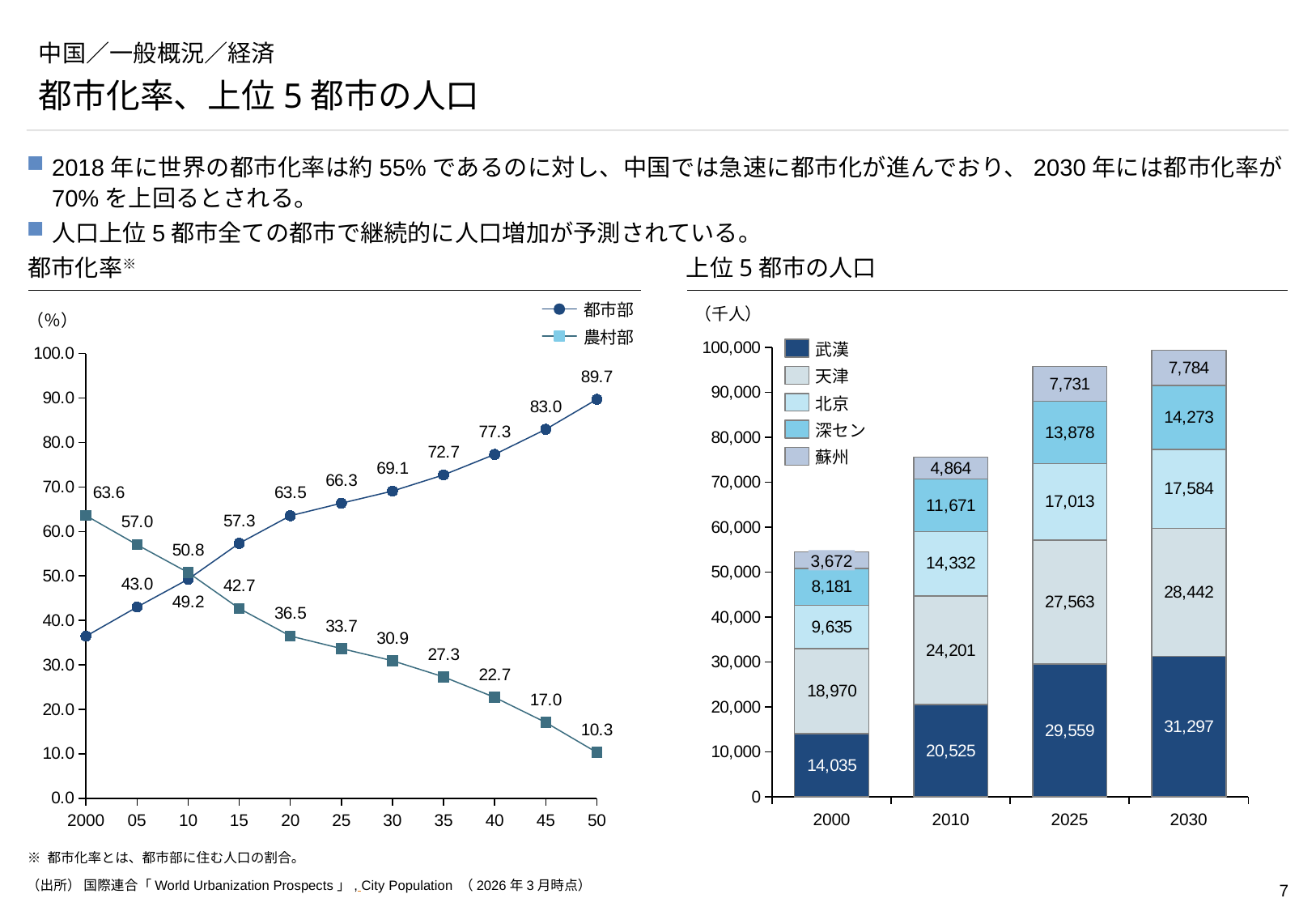
In the 上位5都市の人口 chart on the right, what is the total of the stacked bar for 2000? 54,493 In the 上位5都市の人口 chart on the right, which city has the largest value in 2030? 武漢 In the 上位5都市の人口 chart on the right, what is the value for 天津 in 2025? 27,563 In the 都市化率 chart on the left, does the 農村部 series rise or fall from 2000 to 2050? fall In the 都市化率 chart on the left, what is the 都市部 value for 2050? 89.7 In the 上位5都市の人口 chart on the right, how many years are shown on the x axis? 4 In the 都市化率 chart on the left, is the 都市部 value for 2000 greater or less than 40.0? less In the 上位5都市の人口 chart on the right, what is the value for 蘇州 in 2010? 4,864 In the 都市化率 chart on the left, how many series does the legend list? 2 In the 都市化率 chart on the left, what is the 農村部 value for 2020? 36.5 What kind of chart is the 上位5都市の人口 chart on the right? stacked bar chart In the 都市化率 chart on the left, what is the difference between the 都市部 and 農村部 values in 2030? 38.2